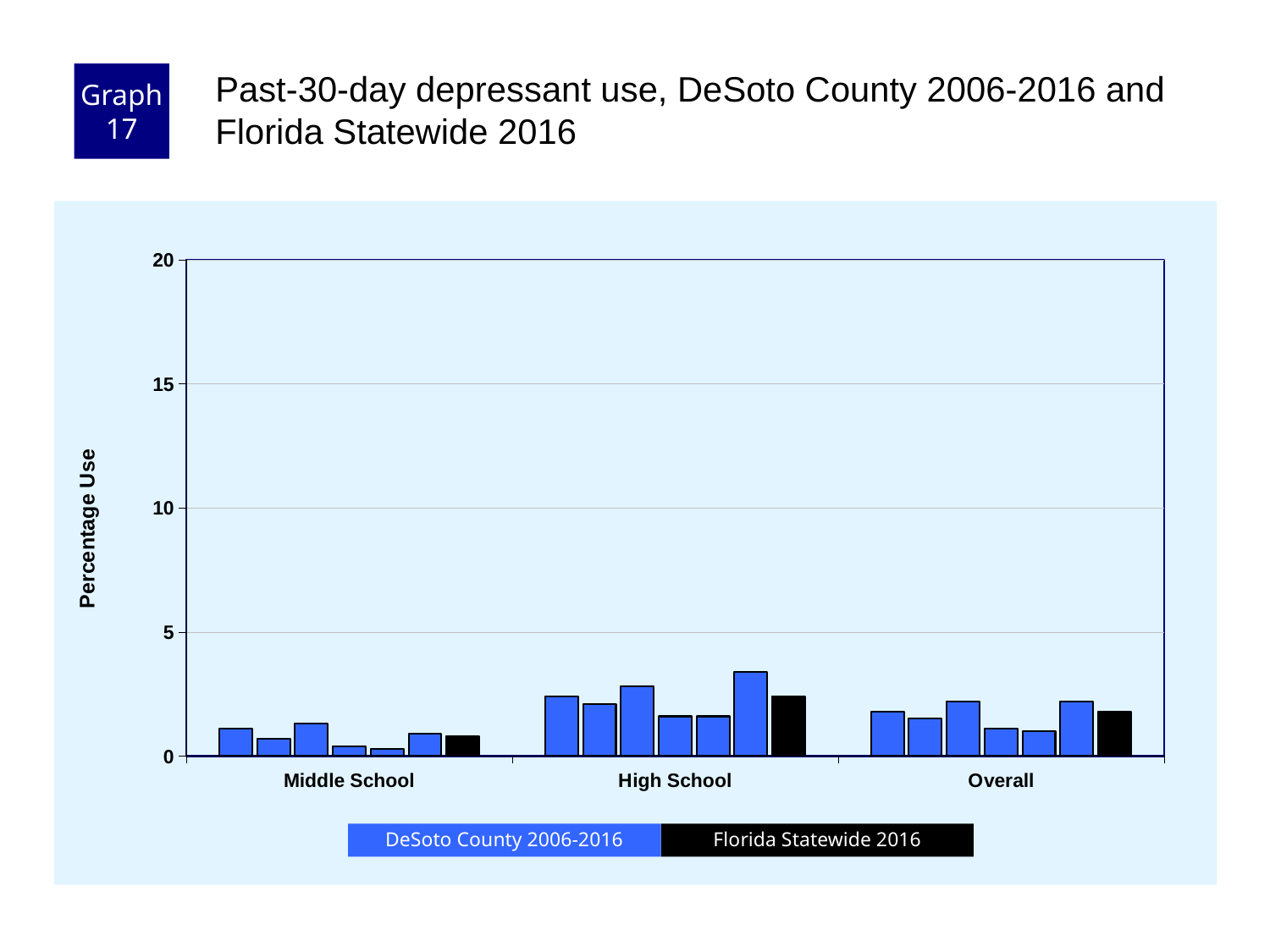
How many category groups are shown on the x axis? 3 Which category group has the lowest bars overall? Middle School Is the tallest bar in the Overall group greater or less than 5? less Which is larger, the Florida Statewide 2016 value for High School or for Middle School? High School How many bars are plotted in the High School group? 7 What kind of chart is shown on the slide? bar chart Which category group contains the tallest bar on the chart? High School What is the label on the y axis? Percentage Use How many series does the legend list? 2 Is the Florida Statewide 2016 value for Middle School greater or less than 5? less Is the Florida Statewide 2016 value for High School greater or less than 5? less Which is larger, the Florida Statewide 2016 value for Overall or for Middle School? Overall